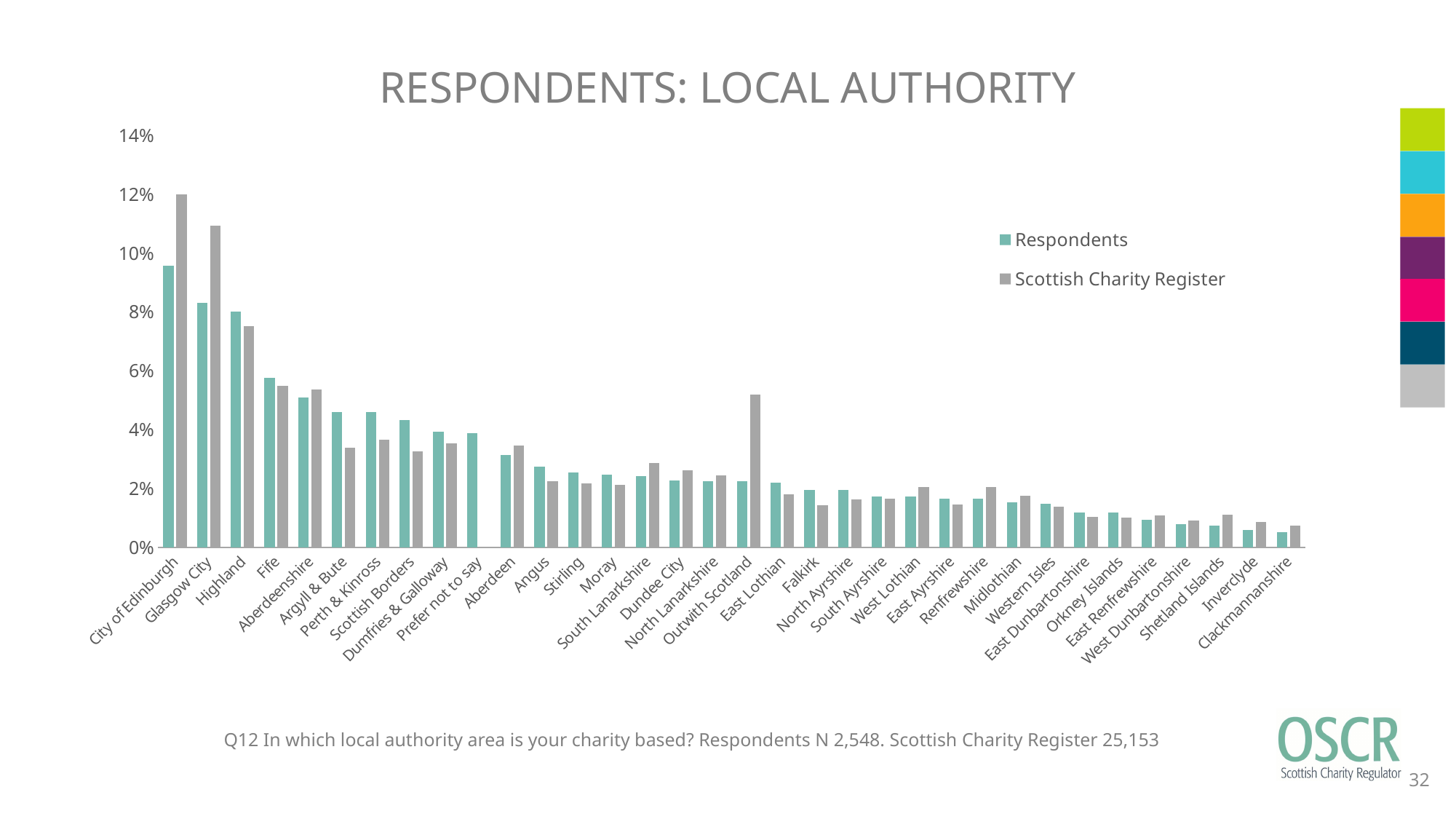
Is the Respondents value for Highland greater or less than 6%? greater Do the Respondents values generally rise or fall from left to right along the x axis? fall How many series does the legend list? 2 Which category has the highest Scottish Charity Register value? City of Edinburgh Is the Scottish Charity Register value for Glasgow City greater or less than 10%? greater Is the Scottish Charity Register value for Outwith Scotland greater or less than 4%? greater How many local authority categories are shown on the x axis? 34 Which category has the highest Respondents value? City of Edinburgh What kind of chart is shown on the slide? bar chart For Glasgow City, which is larger: the Respondents value or the Scottish Charity Register value? Scottish Charity Register For Outwith Scotland, which is larger: the Respondents value or the Scottish Charity Register value? Scottish Charity Register